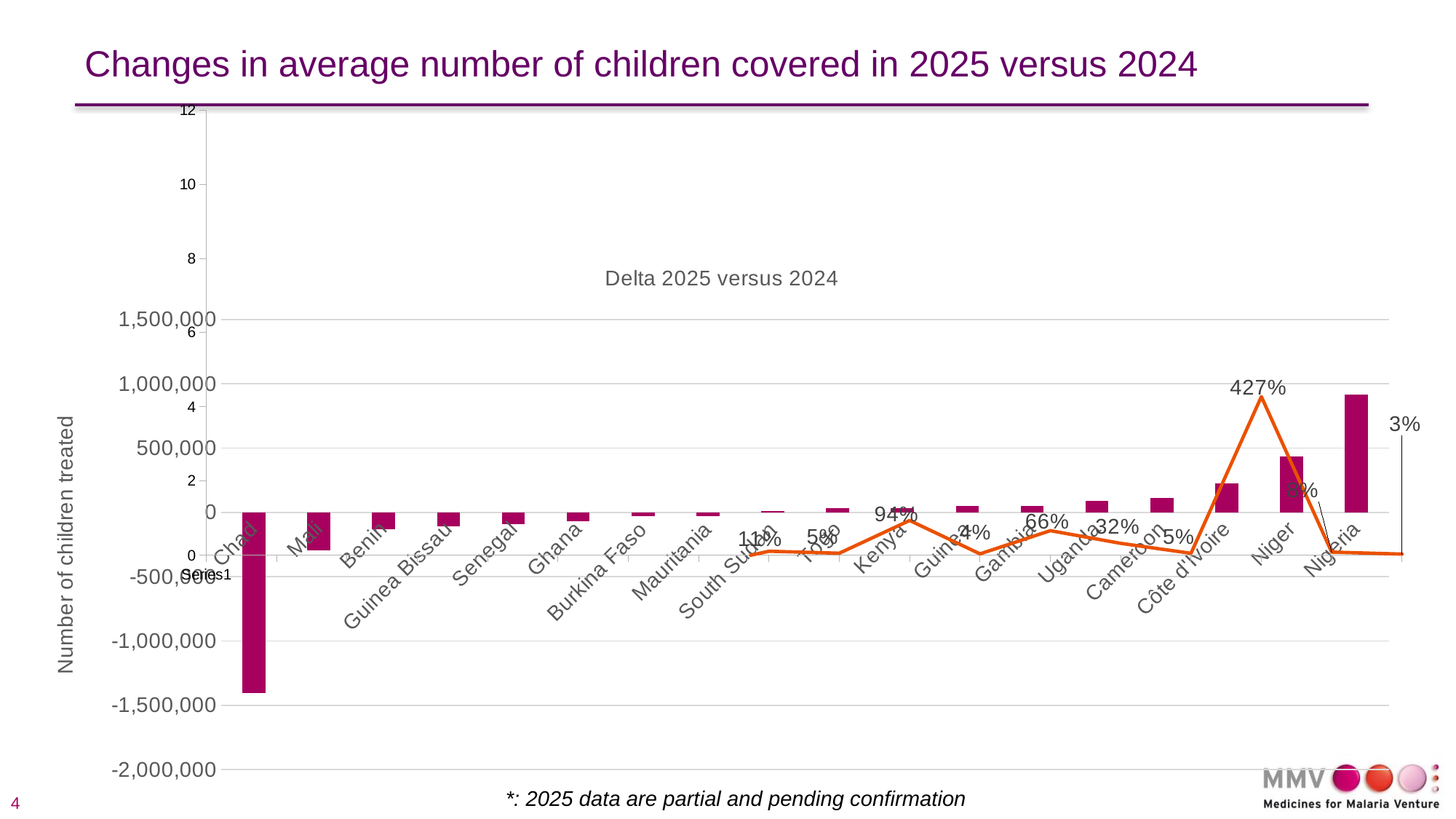
What is the title shown inside the chart area? Delta 2025 versus 2024 Which has the larger bar value, Nigeria or Niger? Nigeria Do the bar values generally rise or fall moving from left to right along the x axis? rise Is the bar value for Niger greater or less than 500,000? less Which country has the highest bar in the chart? Nigeria Is the bar value for Chad greater or less than -1,000,000? less Which country has the lowest (most negative) bar in the chart? Chad What percentage is labelled on the line for Kenya? 94% How many countries are shown along the x axis of the chart? 18 Is the bar value for Nigeria greater or less than 500,000? greater What is the highest percentage label shown on the orange line? 427% What is the label on the vertical axis of the chart? Number of children treated